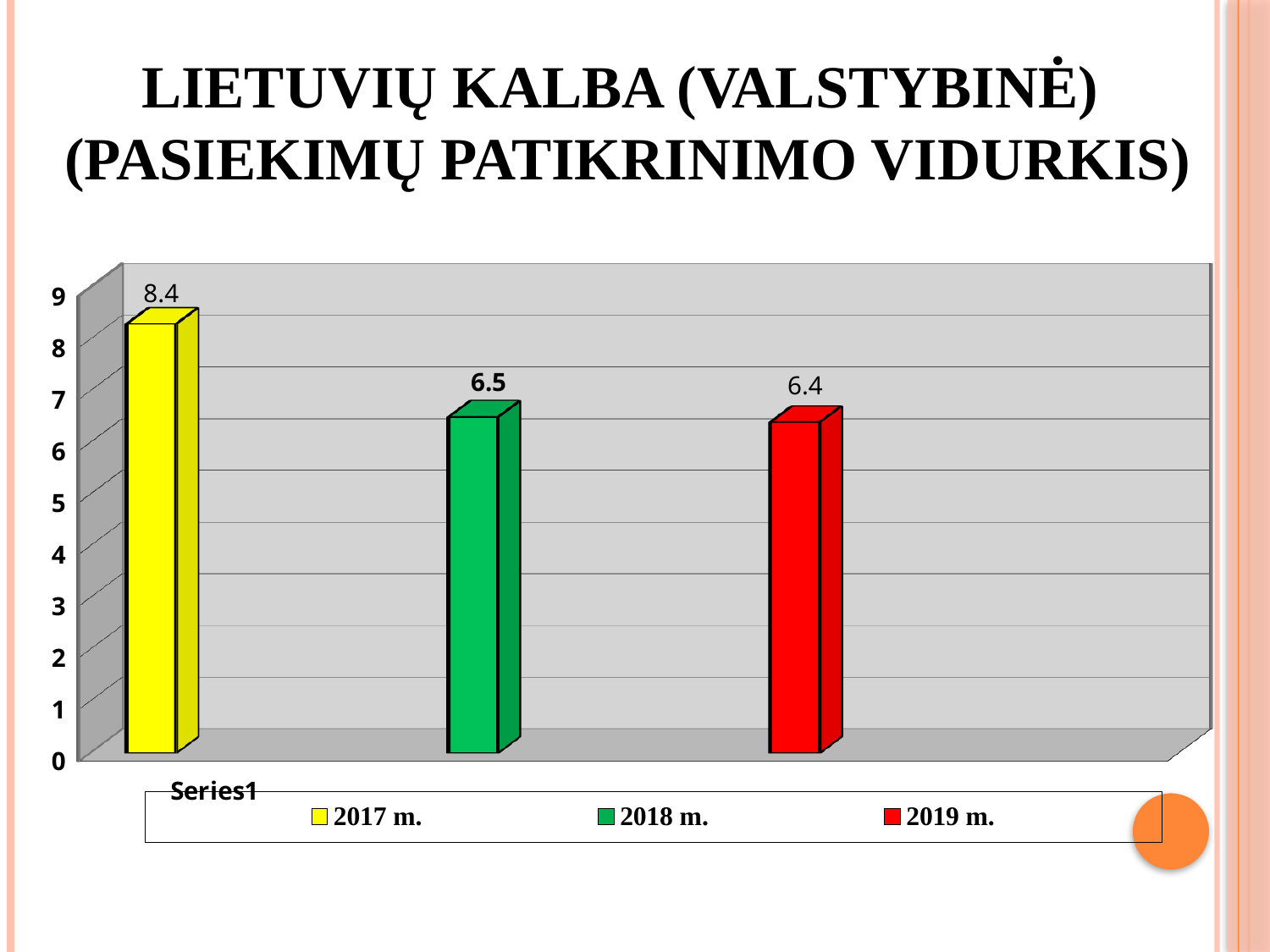
What is the value for 2017 m.? 8.4 What is the value for 2018 m.? 6.5 What is the difference between the values for 2017 m. and 2019 m.? 2.0 What colour is the bar for 2019 m.? red What is the difference between the values for 2017 m. and 2018 m.? 1.9 Is the value for 2018 m. greater or less than 7? less Which is larger, the value for 2017 m. or the value for 2018 m.? 2017 m. What is the value for 2019 m.? 6.4 Is the value for 2017 m. greater or less than 8? greater How many series does the legend list? 3 Which year has the highest value? 2017 m. What kind of chart is shown on the slide? bar chart